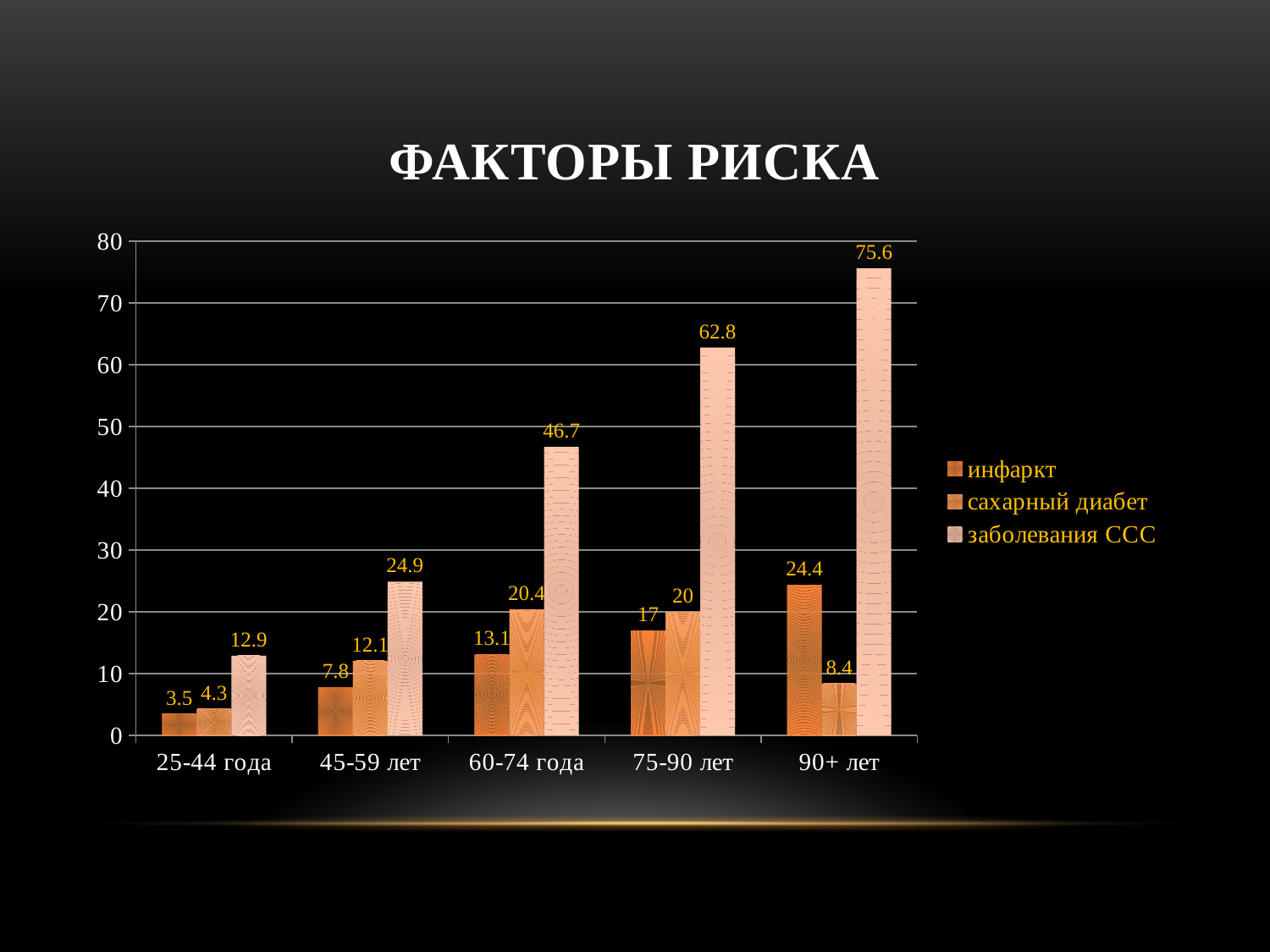
Does the value for заболевания ССС rise or fall as age increases along the x axis? rise What is the difference between the заболевания ССС values for 75-90 лет and 60-74 года? 16.1 What is the value for заболевания ССС in the 90+ лет category? 75.6 What is the title of the chart? ФАКТОРЫ РИСКА What is the value for сахарный диабет in the 45-59 лет category? 12.1 In the 90+ лет category, which is larger: инфаркт or сахарный диабет? инфаркт How many age categories are shown on the x axis? 5 What is the value for инфаркт in the 60-74 года category? 13.1 Which age category has the highest value for инфаркт? 90+ лет What type of chart is shown on the slide? bar chart How many series does the legend list? 3 Which age category has the lowest value for заболевания ССС? 25-44 года